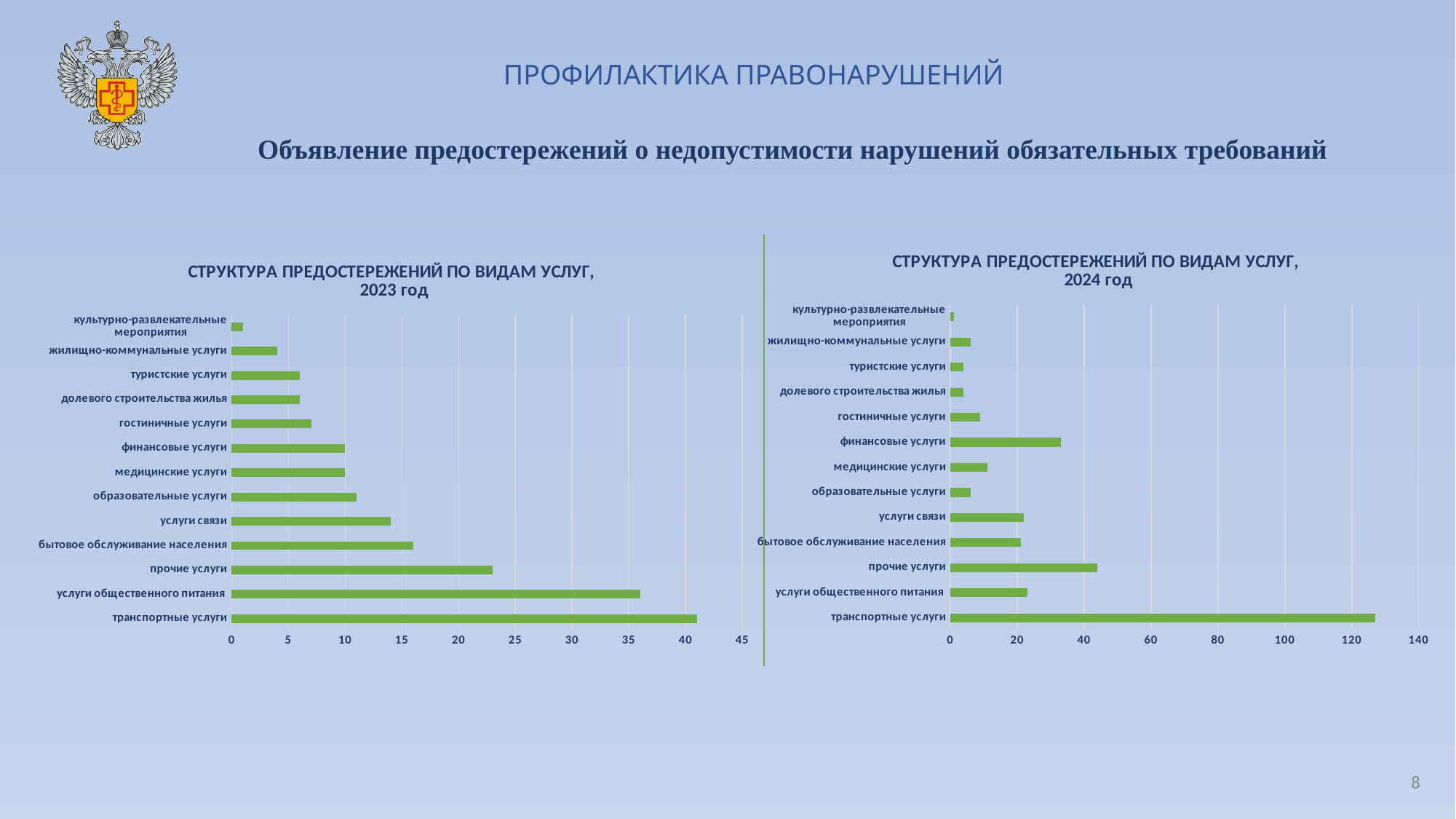
In the left chart (2023 год), which category has the highest value? транспортные услуги What kind of chart is the left chart, 'СТРУКТУРА ПРЕДОСТЕРЕЖЕНИЙ ПО ВИДАМ УСЛУГ, 2023 год'? bar chart In the left chart (2023 год), is the value for прочие услуги greater or less than 25? less In the left chart (2023 год), which category has the lowest value? культурно-развлекательные мероприятия In the right chart (2024 год), which is larger: прочие услуги or финансовые услуги? прочие услуги In the right chart (2024 год), which category has the lowest value? культурно-развлекательные мероприятия How many categories are shown in the left chart (2023 год)? 13 What is the highest value shown on the x axis of the right chart (2024 год)? 140 In the right chart (2024 год), is the value for транспортные услуги greater or less than 120? greater In the left chart (2023 год), is the value for услуги общественного питания greater or less than 30? greater In the left chart (2023 год), which is larger: бытовое обслуживание населения or услуги связи? бытовое обслуживание населения In the right chart (2024 год), which category has the highest value? транспортные услуги